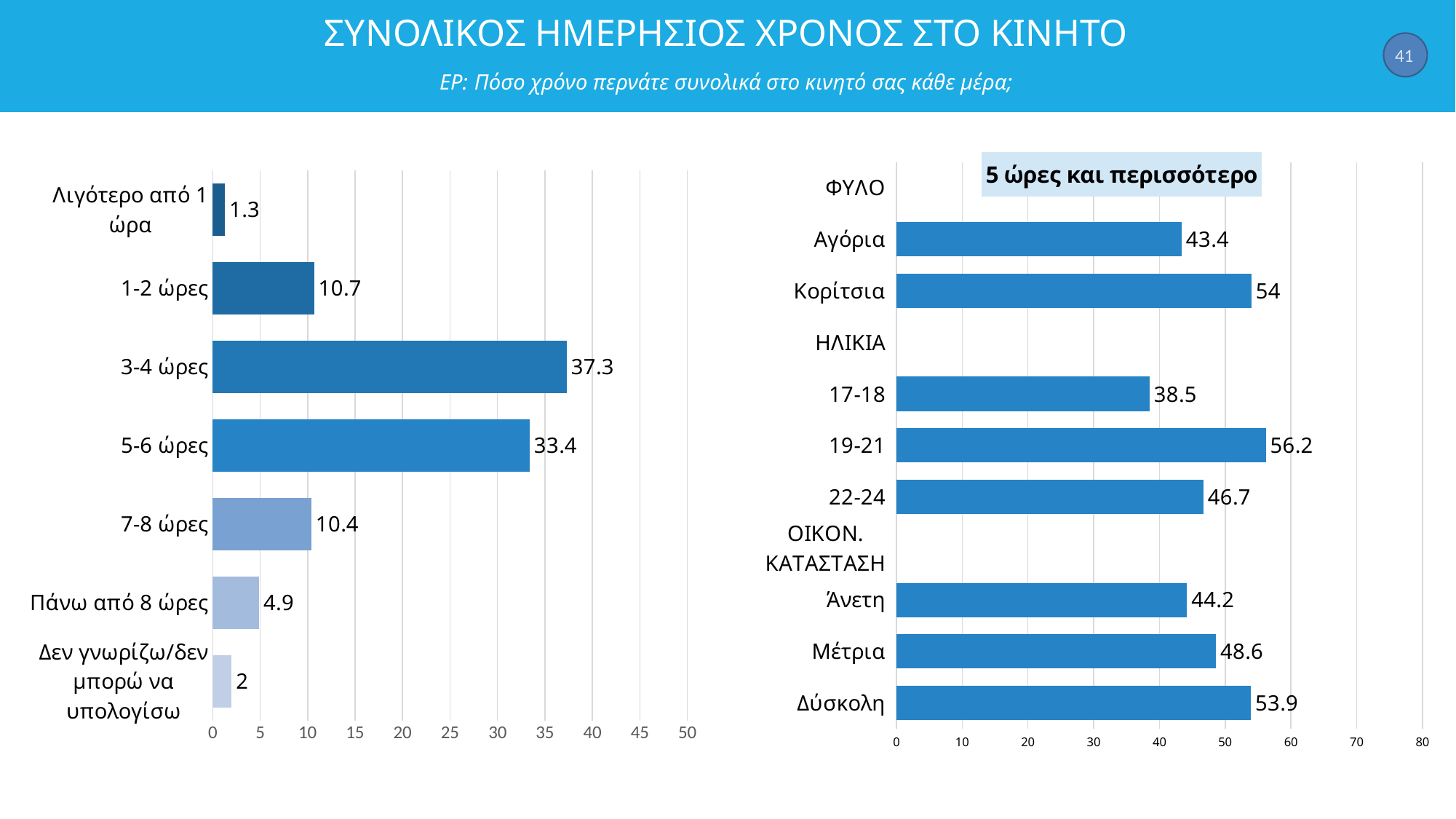
What kind of chart is the chart titled '5 ώρες και περισσότερο'? Bar chart In the chart titled '5 ώρες και περισσότερο', which is larger, the value for Άνετη or the value for Δύσκολη? Δύσκολη In the left chart, which category has the highest value? 3-4 ώρες In the chart titled '5 ώρες και περισσότερο', which category has the lowest value? 17-18 In the left chart, what is the value for 3-4 ώρες? 37.3 In the chart titled '5 ώρες και περισσότερο', what is the value for 22-24? 46.7 In the left chart, what is the value for Πάνω από 8 ώρες? 4.9 In the chart titled '5 ώρες και περισσότερο', which category has the highest value? 19-21 In the left chart, how many categories are shown? 7 In the chart titled '5 ώρες και περισσότερο', what is the value for Κορίτσια? 54 In the left chart, what is the difference between the values for 3-4 ώρες and 5-6 ώρες? 3.9 In the left chart, which category has the lowest value? Λιγότερο από 1 ώρα